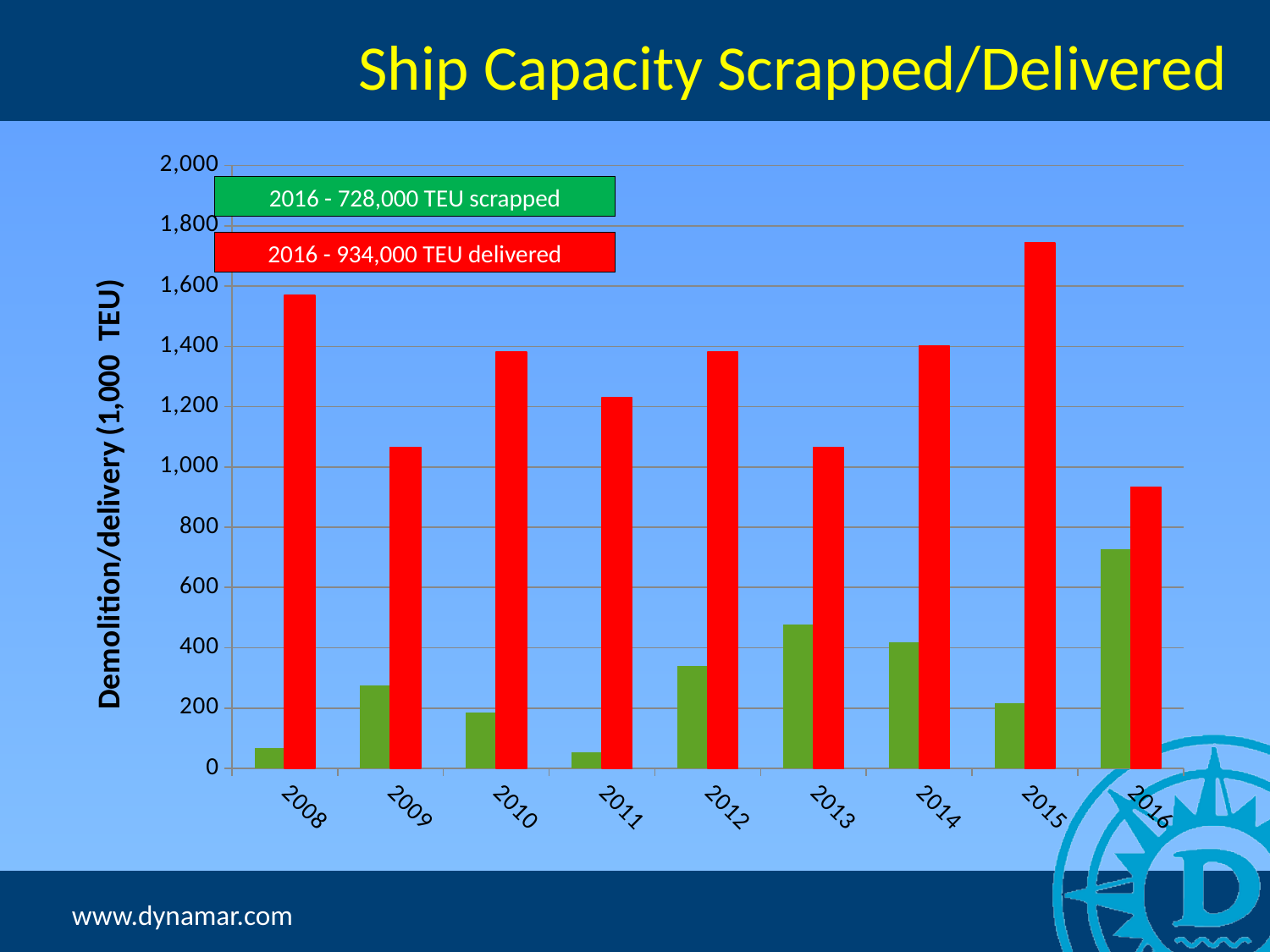
According to the slide, how much capacity was scrapped in 2016? 728,000 TEU According to the slide, how much capacity was delivered in 2016? 934,000 TEU What kind of chart is shown on the slide? bar chart How much more capacity was delivered than scrapped in 2016? 206,000 TEU Is the delivered capacity for 2008 greater or less than 1,400? greater In which year was the scrapped capacity (green bars) highest? 2016 In which year was the delivered capacity (red bars) highest? 2015 Which year had the larger delivered capacity, 2011 or 2012? 2012 Is the delivered capacity for 2009 greater or less than 1,200? less In which year was the delivered capacity (red bars) lowest? 2016 How many years are shown on the x axis of the chart? 9